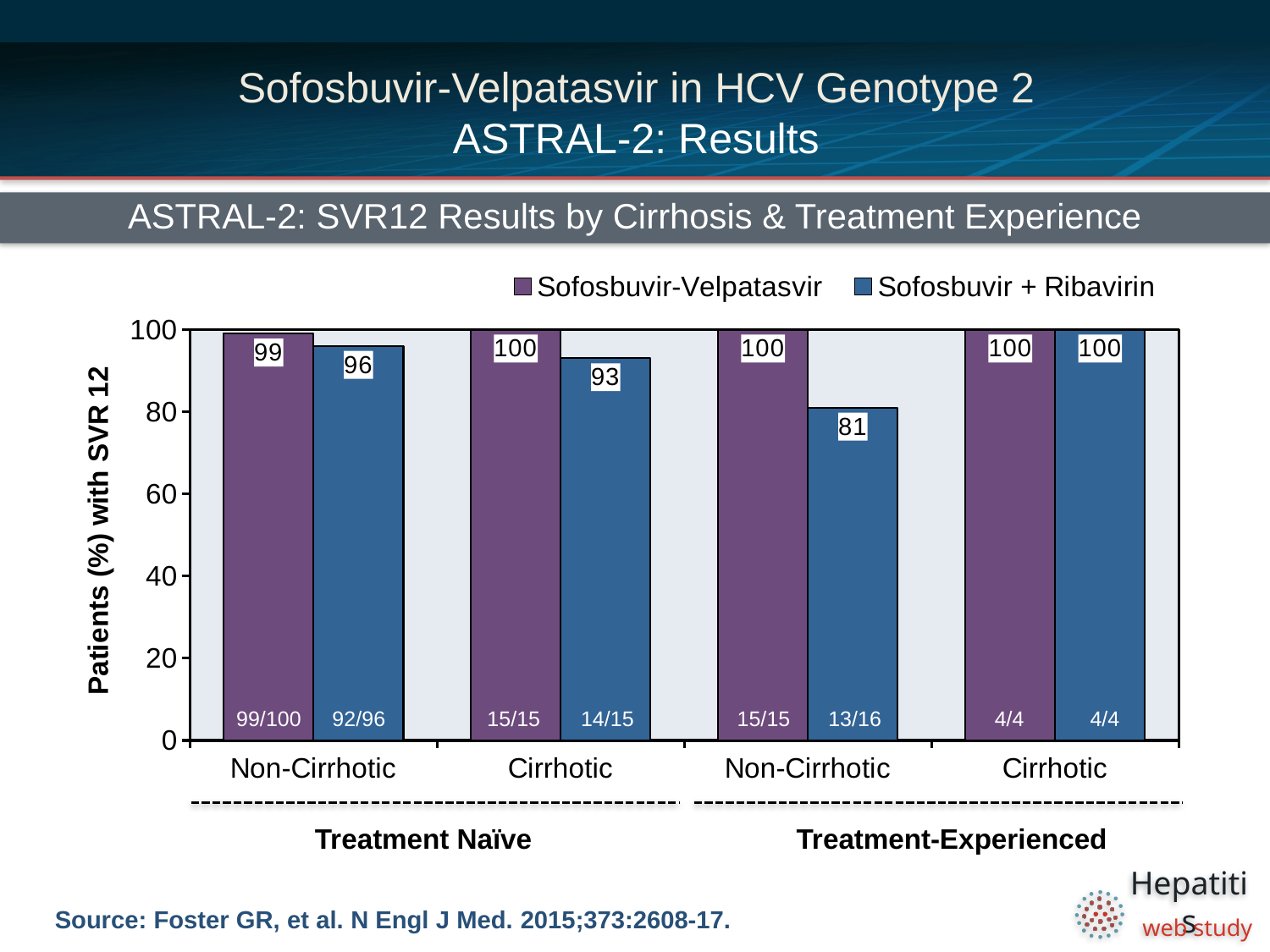
Which is larger in Treatment Naïve Cirrhotic patients: the SVR12 rate for Sofosbuvir-Velpatasvir or for Sofosbuvir + Ribavirin? Sofosbuvir-Velpatasvir What is the SVR12 rate for Sofosbuvir-Velpatasvir in Treatment Naïve Non-Cirrhotic patients? 99 Is the SVR12 rate for Sofosbuvir + Ribavirin in Treatment-Experienced Non-Cirrhotic patients greater or less than 80? greater What is the SVR12 rate for Sofosbuvir + Ribavirin in Treatment-Experienced Non-Cirrhotic patients? 81 What kind of chart is shown on the slide? Bar chart What is the SVR12 rate for Sofosbuvir + Ribavirin in Treatment Naïve Cirrhotic patients? 93 What is the difference in SVR12 rate between Sofosbuvir-Velpatasvir and Sofosbuvir + Ribavirin in Treatment-Experienced Non-Cirrhotic patients? 19 What is the label of the y axis? Patients (%) with SVR 12 Which Sofosbuvir + Ribavirin group has the lowest SVR12 rate? Treatment-Experienced Non-Cirrhotic How many series does the legend list? 2 How many patients are represented by the Sofosbuvir + Ribavirin bar for Treatment Naïve Non-Cirrhotic patients (n/N)? 92/96 How many patient groups are shown on the x axis? 4